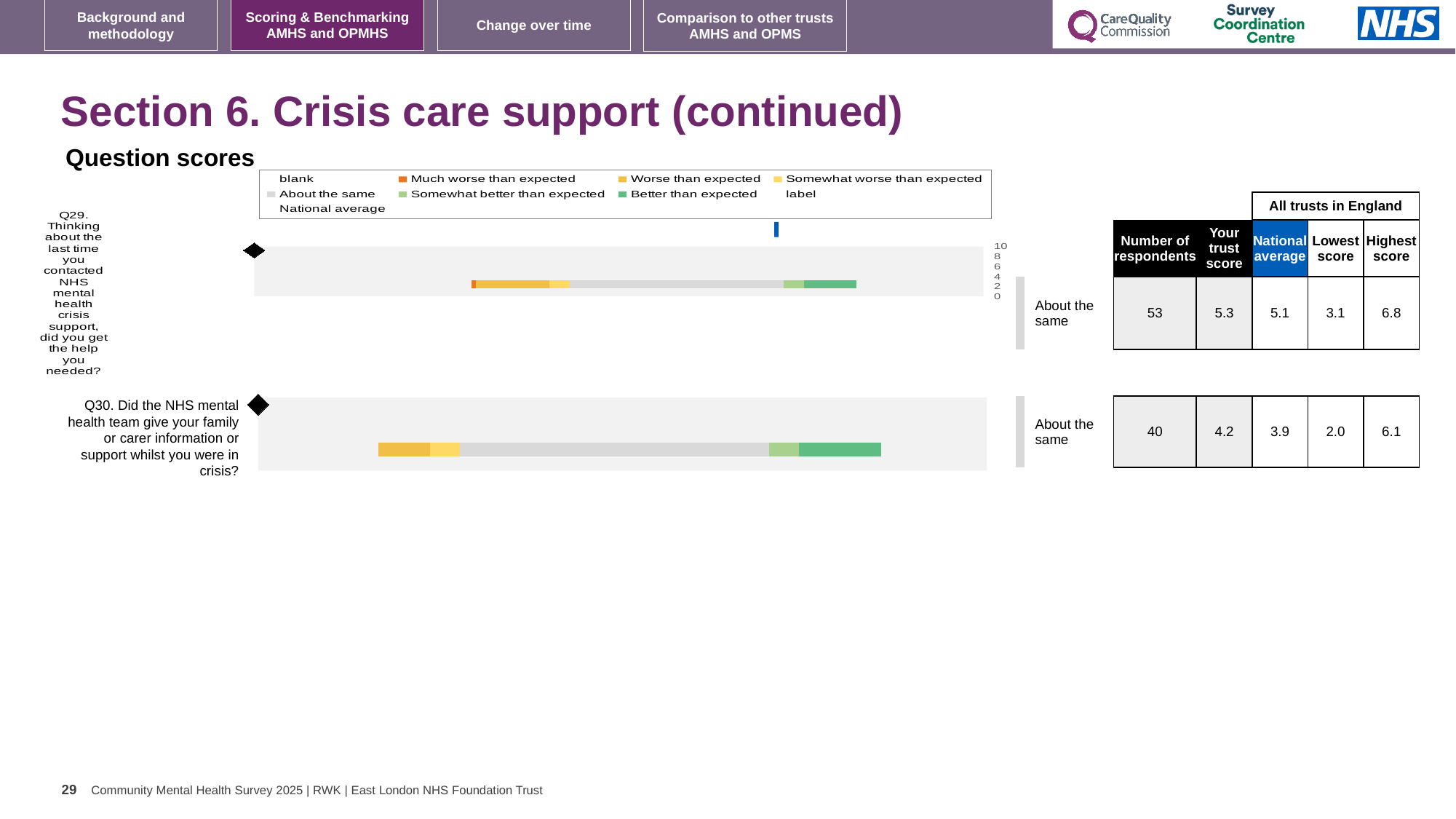
In the question scores chart legend, which colour represents 'Better than expected'? green How many entries does the legend of the question scores chart list? 9 In the question scores chart legend, which colour represents 'Much worse than expected'? orange Which question has the higher 'Your trust score', Q29 or Q30? Q29 What is the 'Your trust score' value for Q30? 4.2 What is the national average score for Q30? 3.9 What benchmark category is shown next to the bar for Q29? About the same What is the difference between the trust score and the national average for Q29? 0.2 What is the number of respondents for Q29? 53 What kind of chart is used to show the question scores on this slide? bar chart What is the difference between the highest scores for Q29 and Q30? 0.7 How many questions (categories) are plotted in the question scores chart? 2